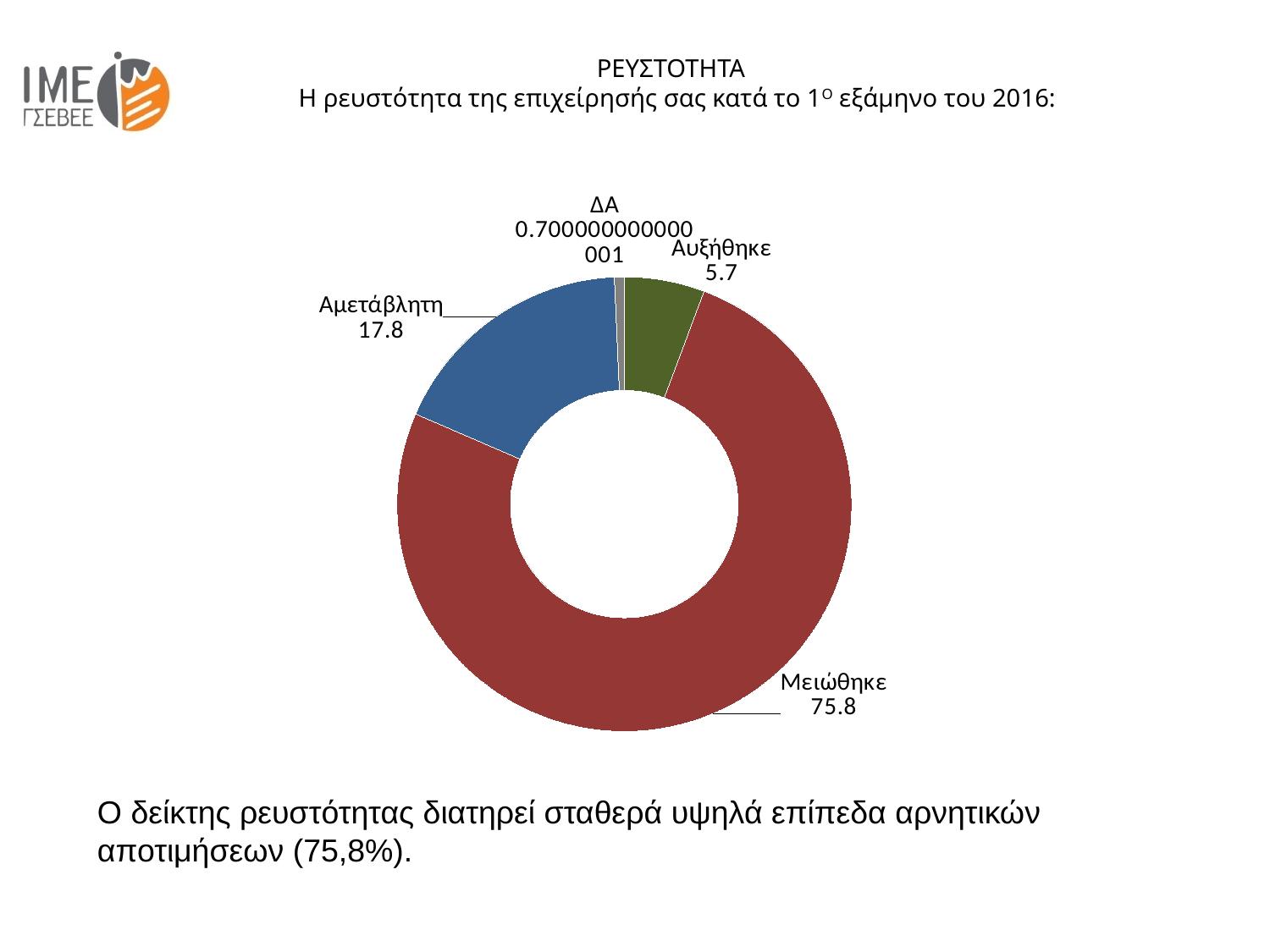
Which category has the smallest slice in the doughnut chart? ΔΑ What is the title of the chart on the slide? ΡΕΥΣΤΟΤΗΤΑ Η ρευστότητα της επιχείρησής σας κατά το 1ο εξάμηνο του 2016: How many categories are shown in the doughnut chart? 4 What is the value for Μειώθηκε in the doughnut chart? 75.8 What is the value for Αυξήθηκε in the doughnut chart? 5.7 What is the difference between the values for Αμετάβλητη and Αυξήθηκε? 12.1 Which category has the largest slice in the doughnut chart? Μειώθηκε What is the difference between the values for Μειώθηκε and Αμετάβλητη? 58 Which is larger, the value for Αμετάβλητη or the value for Αυξήθηκε? Αμετάβλητη What kind of chart is shown on the slide? doughnut chart What is the value for Αμετάβλητη in the doughnut chart? 17.8 What colour is the Μειώθηκε slice in the doughnut chart? red